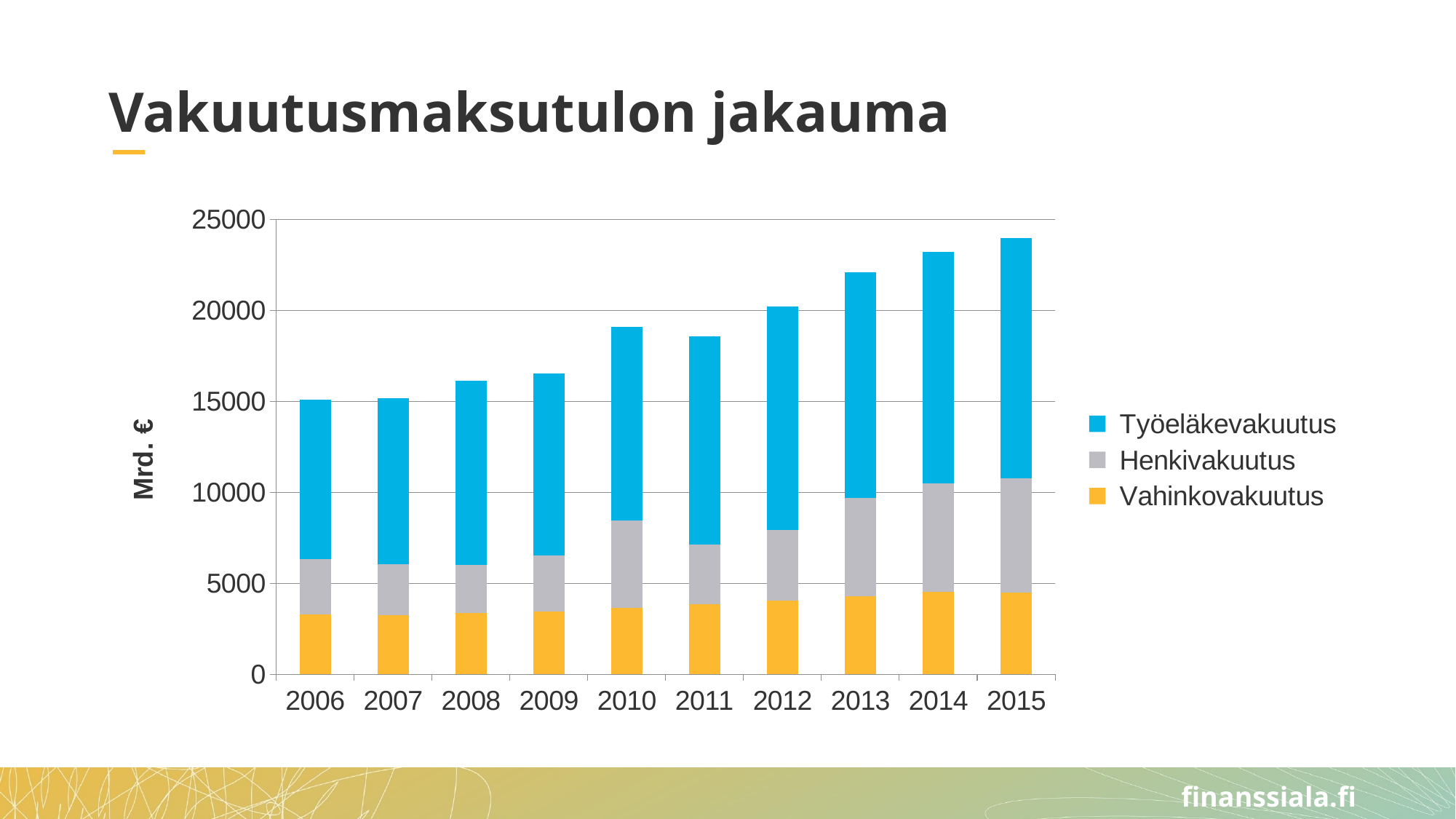
Is the Vahinkovakuutus segment for 2006 greater or less than 5000? less Which series is shown in blue in the chart? Työeläkevakuutus Which year has the larger total bar, 2010 or 2011? 2010 What kind of chart is shown on the slide? Stacked bar chart Is the total bar for 2010 greater or less than 20000? less How many series does the chart legend list? 3 Is the total bar for 2006 greater or less than 20000? less How many years are shown on the x axis of the chart? 10 Which year has the highest total bar in the chart? 2015 Do the total bars generally rise or fall from 2006 to 2015? rise What is the title of the chart slide? Vakuutusmaksutulon jakauma